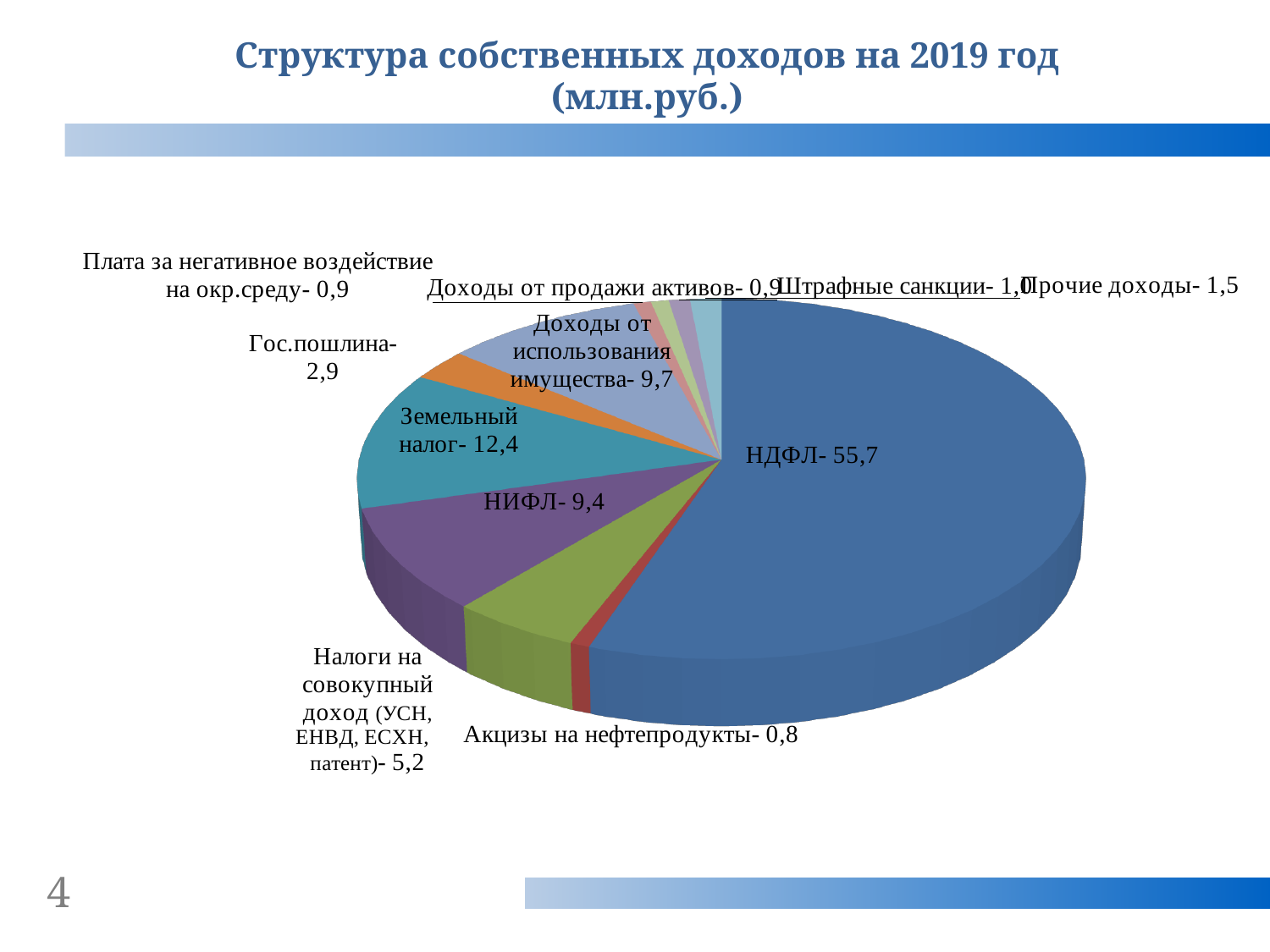
What is the value for Доходы от использования имущества? 9,7 How many slices does the pie chart have? 11 Which category has the largest slice of the pie? НДФЛ What is the difference between the values for НДФЛ and Земельный налог? 43,3 What is the value for Акцизы на нефтепродукты? 0,8 What type of chart is shown on the slide? Pie chart What is the value for Гос.пошлина? 2,9 What is the value for НИФЛ? 9,4 What is the value for Земельный налог? 12,4 Which category has the smallest value? Акцизы на нефтепродукты Which is larger, Доходы от использования имущества or НИФЛ? Доходы от использования имущества What is the value for НДФЛ? 55,7